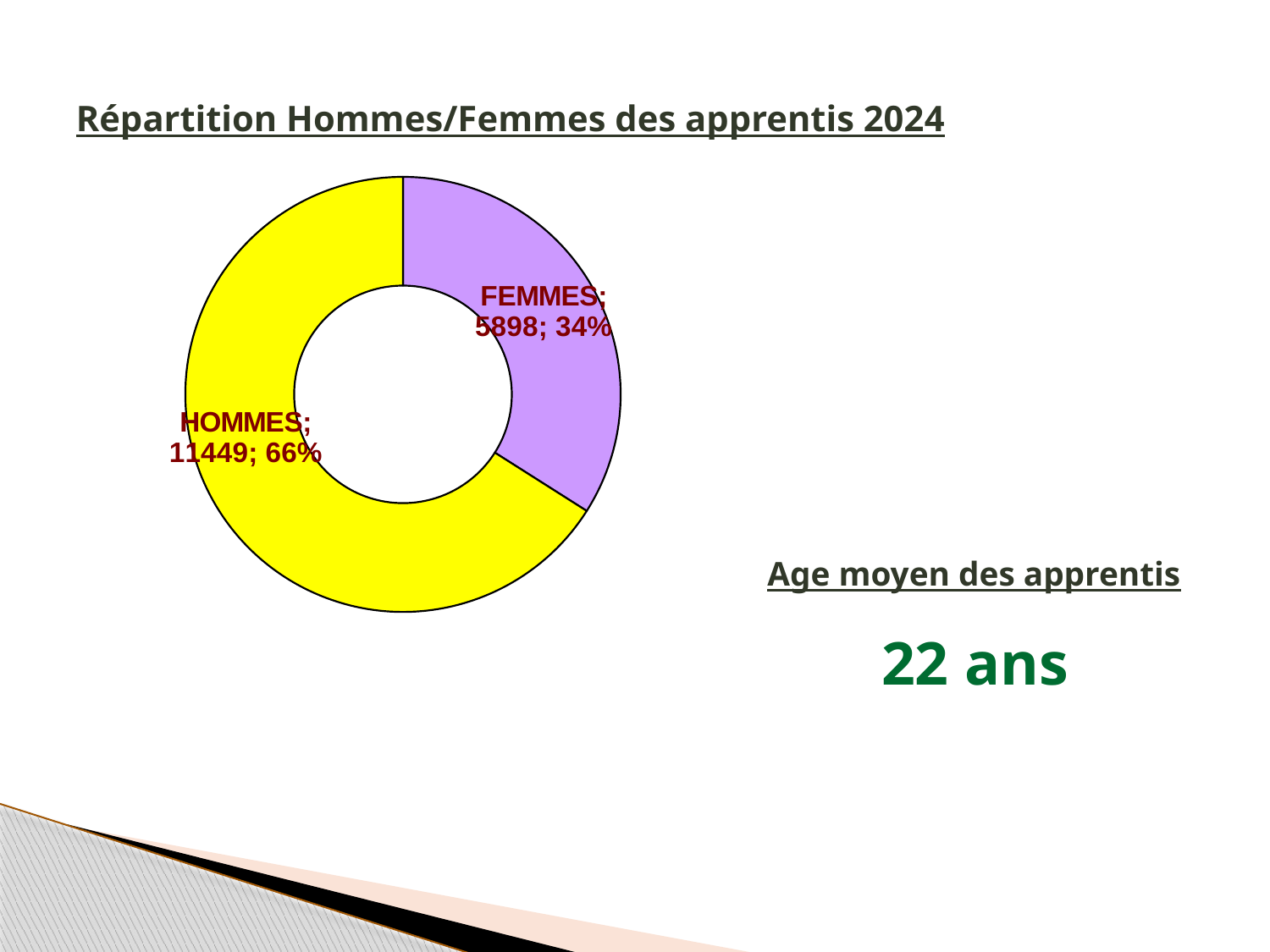
Which category has the largest slice? HOMMES Which is larger, the value for HOMMES or the value for FEMMES? HOMMES How many categories does the chart show? 2 What is the value for FEMMES? 5898 What is the total of the two values shown in the chart? 17347 What kind of chart is shown on the slide? Doughnut (pie) chart What is the value for HOMMES? 11449 Which category has the smallest slice? FEMMES What share of the chart does the FEMMES slice represent? 34% What is the difference between the HOMMES and FEMMES values? 5551 What share of the chart does the HOMMES slice represent? 66% What colour is the HOMMES slice? Yellow